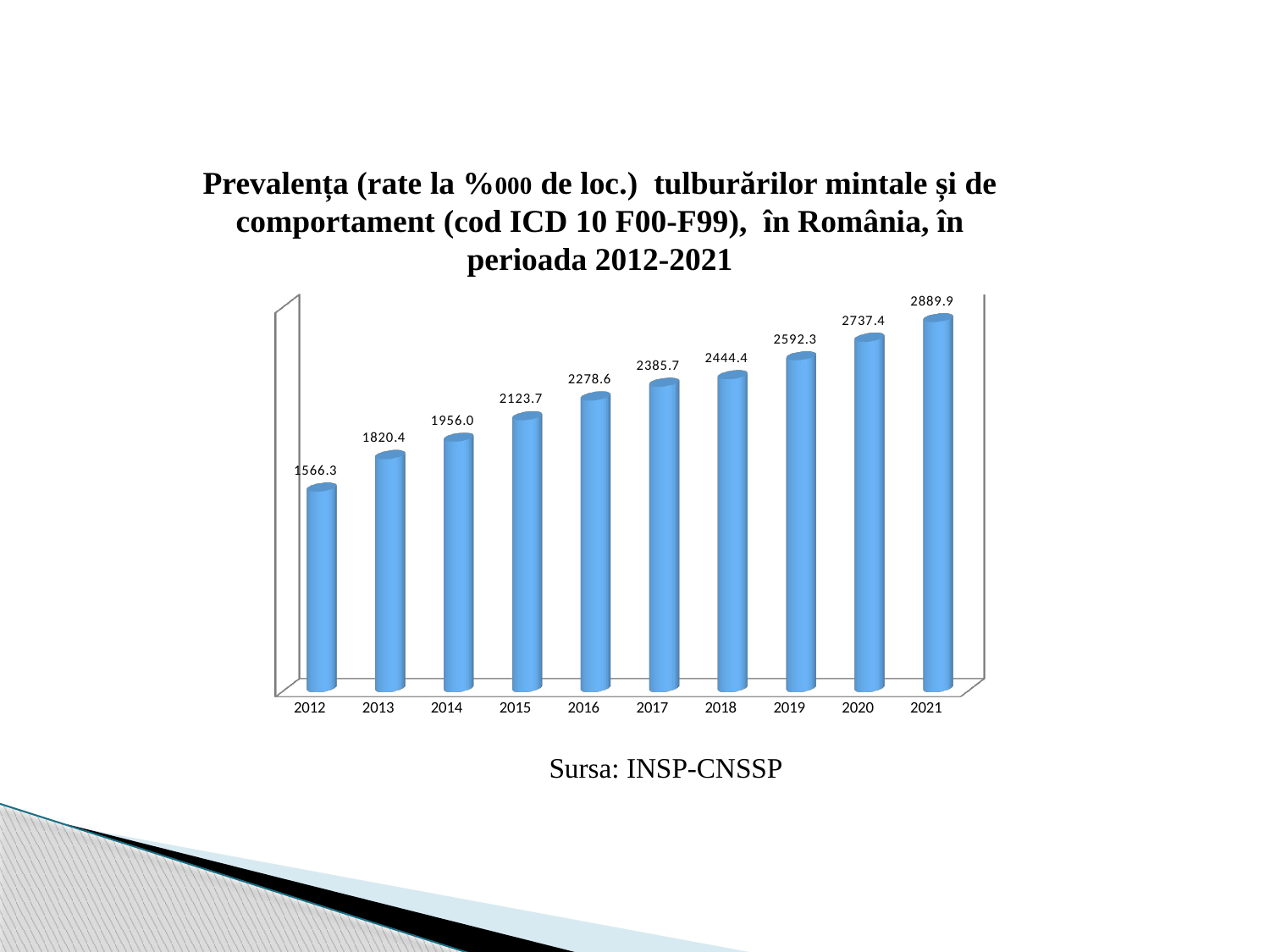
Which year has the highest value? 2021 Which is larger, the value for 2015 or the value for 2016? 2016 What is the difference between the values for 2019 and 2018? 147.9 What is the value for 2017? 2385.7 What kind of chart is shown on the slide? bar chart What source is cited below the chart? INSP-CNSSP What is the value for 2021? 2889.9 What is the difference between the values for 2021 and 2012? 1323.6 How many years are shown on the x axis? 10 Which year has the lowest value? 2012 Do the values rise or fall from 2012 to 2021? rise What is the value for 2012? 1566.3